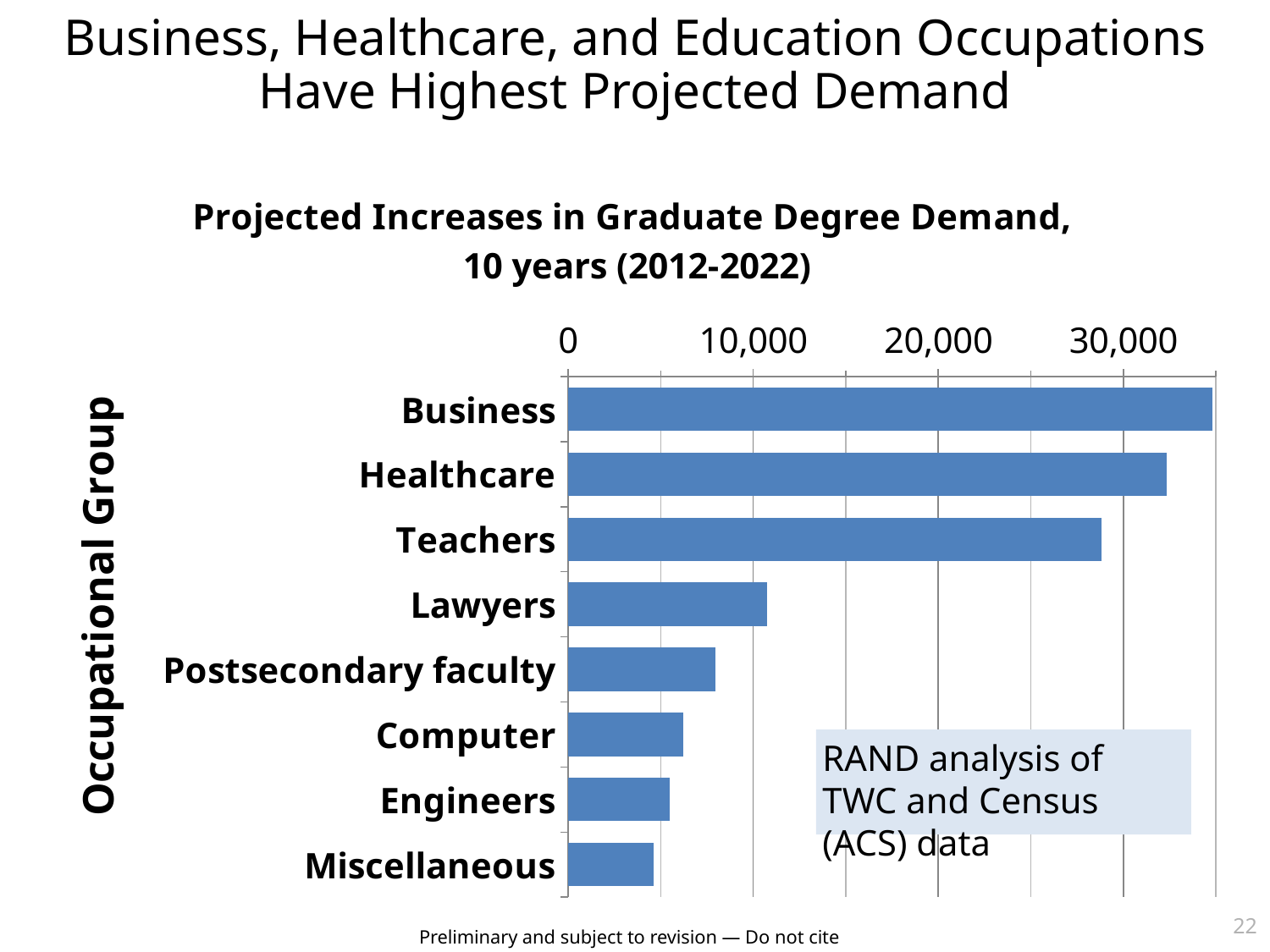
Which occupational group has the lowest projected increase in graduate degree demand? Miscellaneous Which occupational group has the highest projected increase in graduate degree demand? Business Is the value for Healthcare greater or less than 30,000? greater What is the title of the chart? Projected Increases in Graduate Degree Demand, 10 years (2012-2022) Which has a larger projected increase, Teachers or Lawyers? Teachers Is the value for Engineers greater or less than 10,000? less Is the value for Postsecondary faculty greater or less than 10,000? less Which has a larger projected increase, Healthcare or Teachers? Healthcare How many occupational groups are plotted in the chart? 8 What is the label on the vertical axis of the chart? Occupational Group What kind of chart is shown on the slide? bar chart